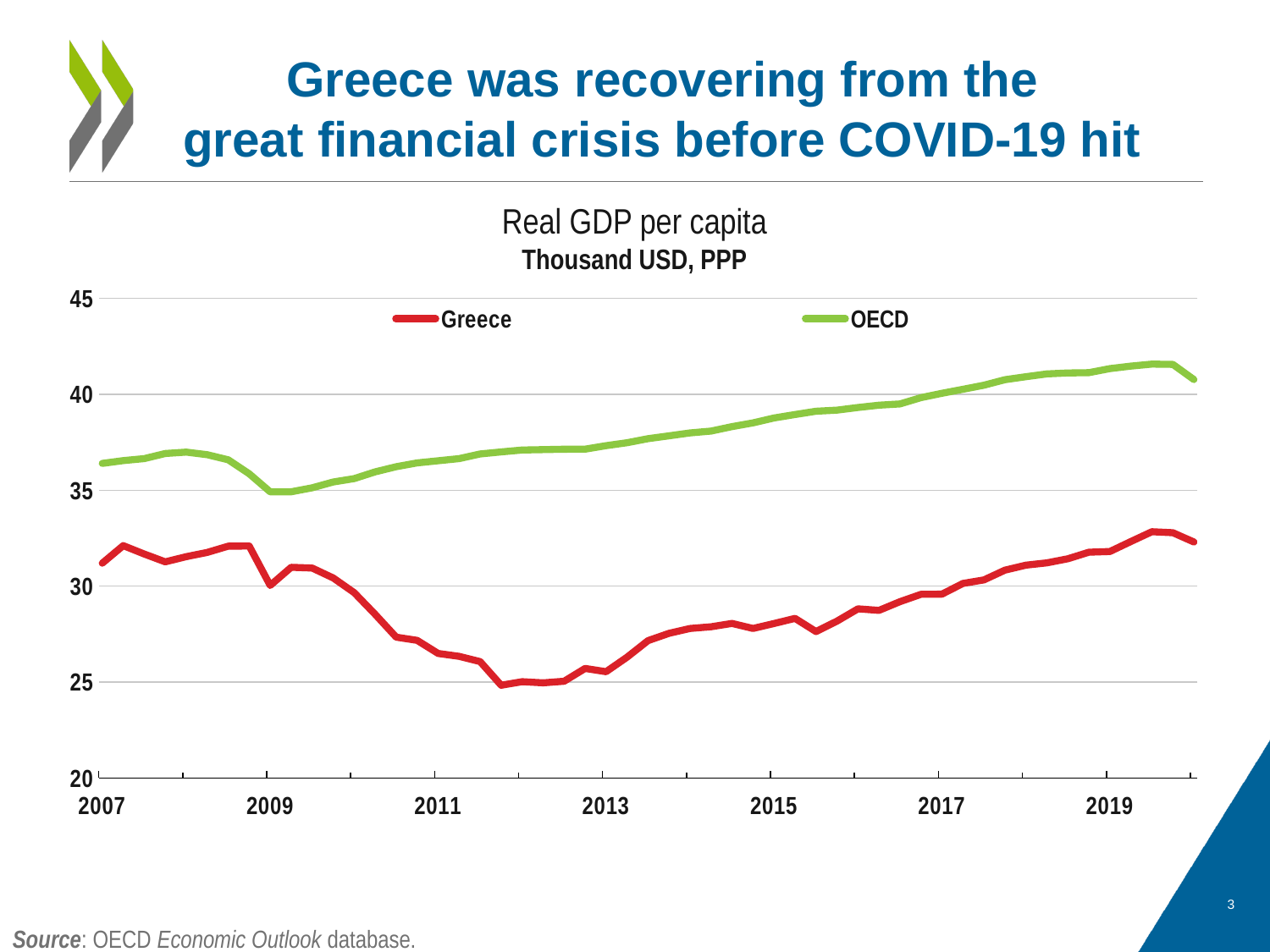
What kind of chart is shown on the slide? line chart Is the value for OECD in 2019 greater or less than 40? greater In what units are the values on the chart expressed? Thousand USD, PPP Is the value for OECD in 2007 greater or less than 35? greater Is the value for Greece in 2015 greater or less than 30? less How many series does the legend list? 2 Which series has the higher value in 2019, Greece or OECD? OECD Does the Greece line rise or fall between 2009 and 2012? fall Does the OECD line rise or fall between 2011 and 2019? rise Around which year does the Greece line reach its lowest point? 2012 What is the title of the chart? Real GDP per capita